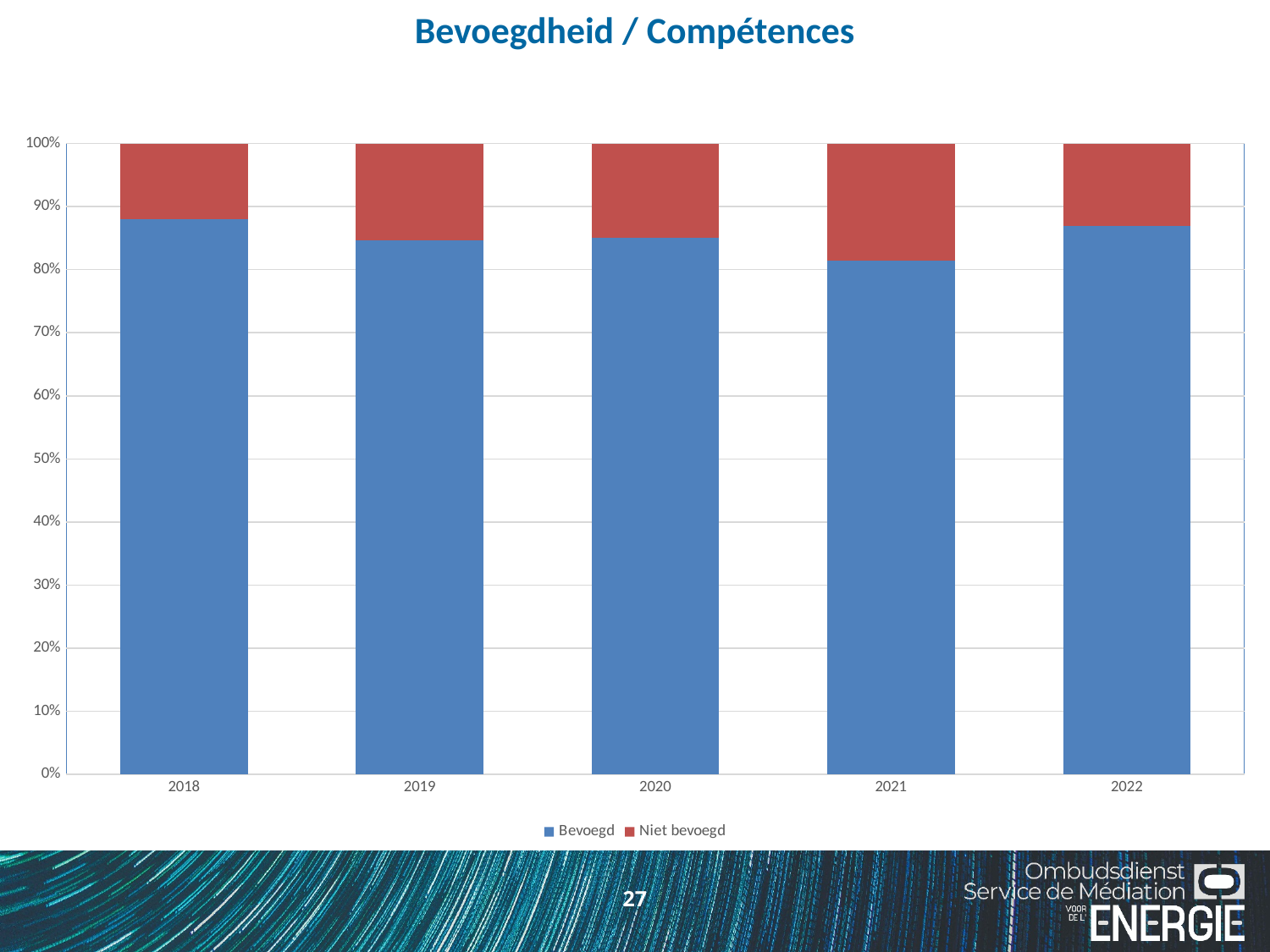
Is the Bevoegd share for 2021 greater or less than 90%? less Which year has a larger Bevoegd share, 2018 or 2021? 2018 Is the Niet bevoegd share for 2020 greater or less than 20%? less In which year is the Bevoegd share the lowest? 2021 What kind of chart is shown on the slide? Stacked bar chart What is the total of the stacked bar for 2019? 100% In which year is the Niet bevoegd share the highest? 2021 How many years are shown on the x axis of the chart? 5 Is the Bevoegd share for 2018 greater or less than 80%? greater What is the title of the chart? Bevoegdheid / Compétences How many series does the legend list? 2 Which series is shown in red in the chart? Niet bevoegd